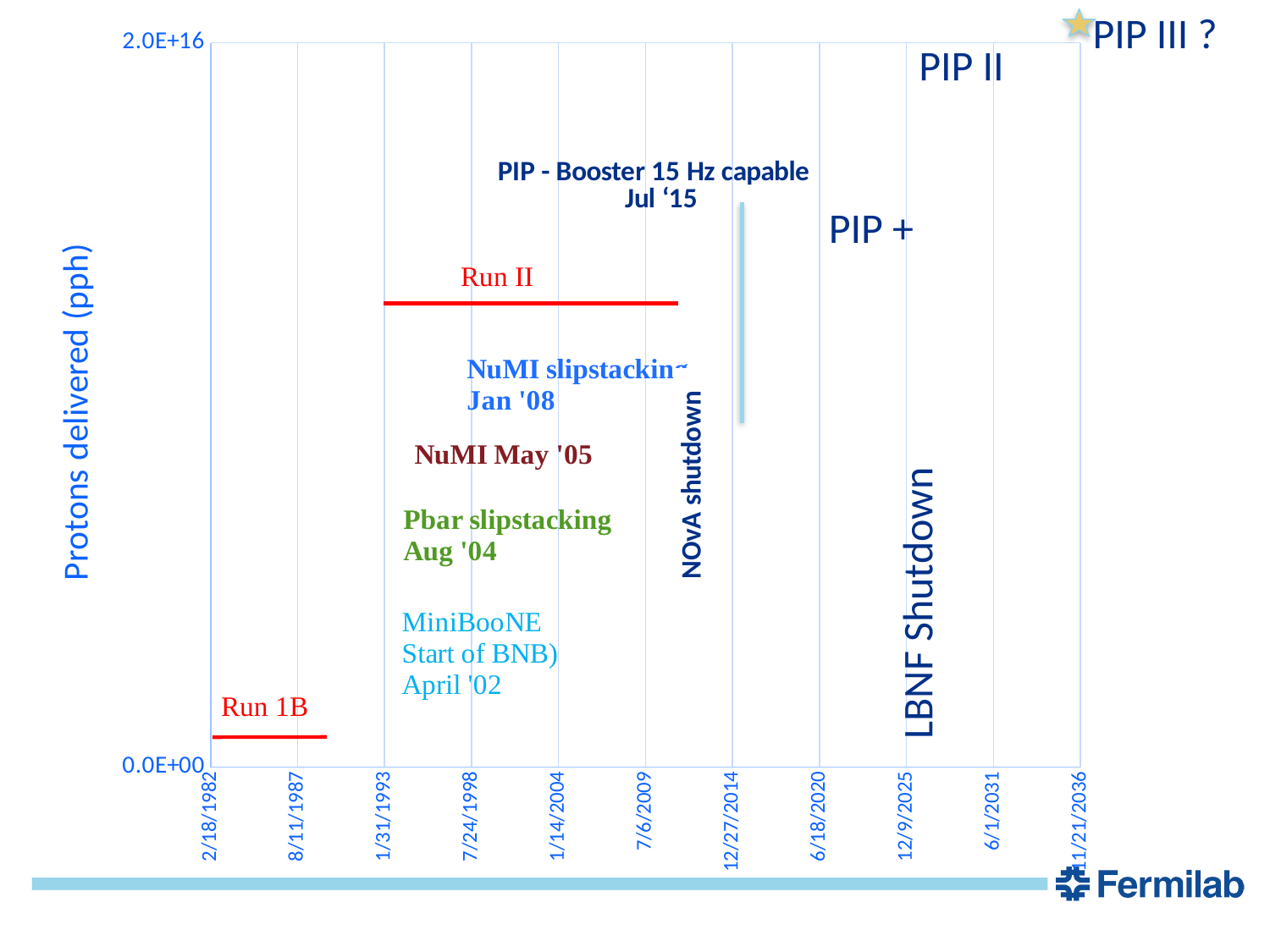
What date is annotated for 'PIP - Booster 15 Hz capable'? Jul '15 What is the first date label on the x axis? 2/18/1982 What is the title of the y axis on the chart? Protons delivered (pph) What is the last date label on the x axis? 11/21/2036 What date is annotated for NuMI slipstacking? Jan '08 What date is annotated for Pbar slipstacking? Aug '04 What is the lowest value shown on the y axis? 0.0E+00 Which shutdown is labeled by the vertical bar near 12/27/2014? NOvA shutdown What date is annotated for the MiniBooNE start of BNB? April '02 What is the highest value shown on the y axis? 2.0E+16 Which run is marked earlier on the timeline, Run 1B or Run II? Run 1B How many date labels are shown on the x axis? 11